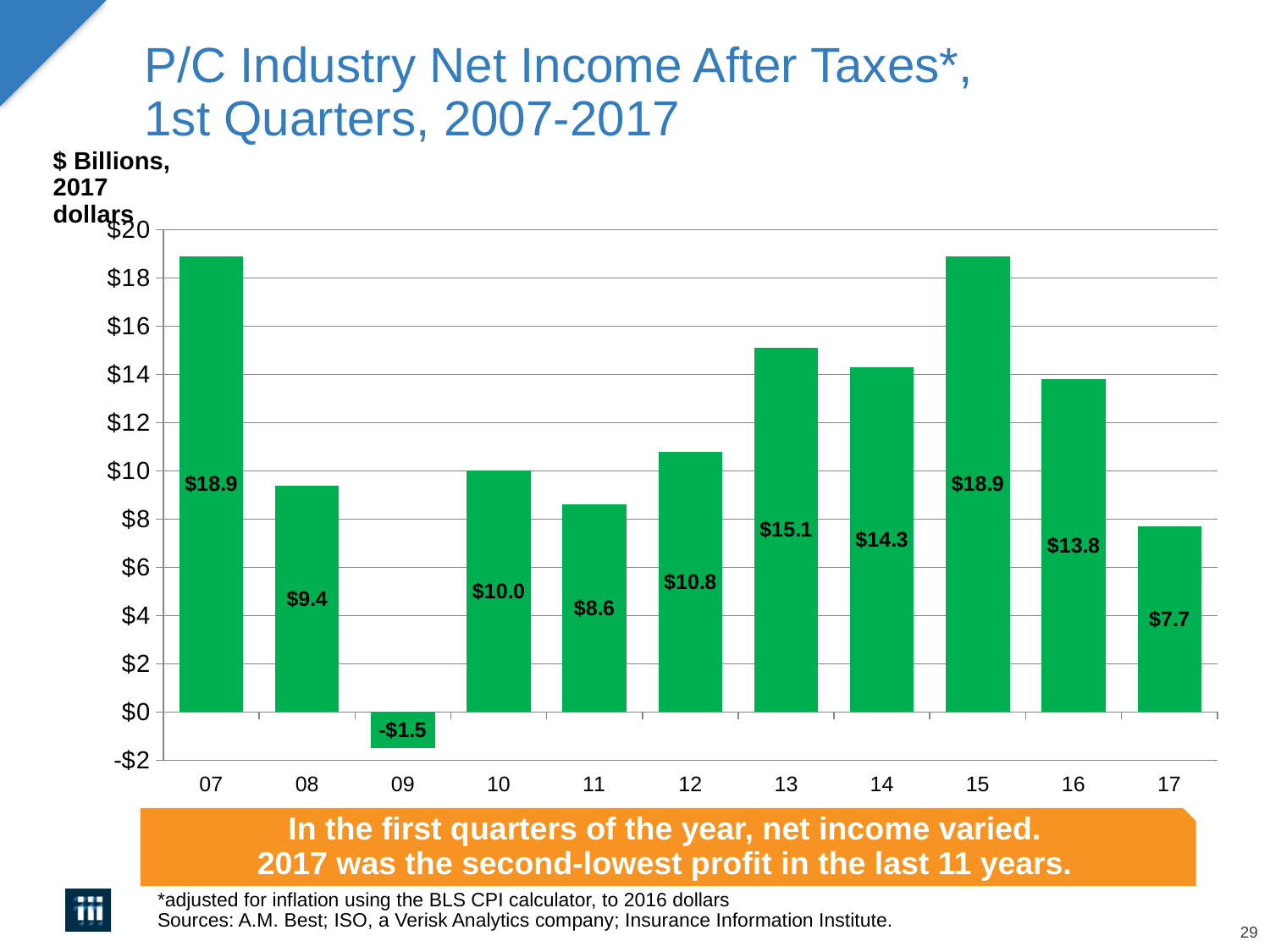
How many years are shown on the x axis? 11 What is the value shown for 2013? $15.1 What is the value shown for 2009? -$1.5 What kind of chart is shown on the slide? Bar chart Which is larger, the value for 2012 or the value for 2011? 2012 Which year has the lowest 1st-quarter net income? 09 What is the difference between the values for 2013 and 2014? $0.8 What unit is stated for the y axis? $ Billions, 2017 dollars Is the value for 2016 greater or less than $12? greater What is the value shown for 2010? $10.0 What is the difference between the values for 2015 and 2016? $5.1 What is the net income after taxes for the 1st quarter of 2017? $7.7